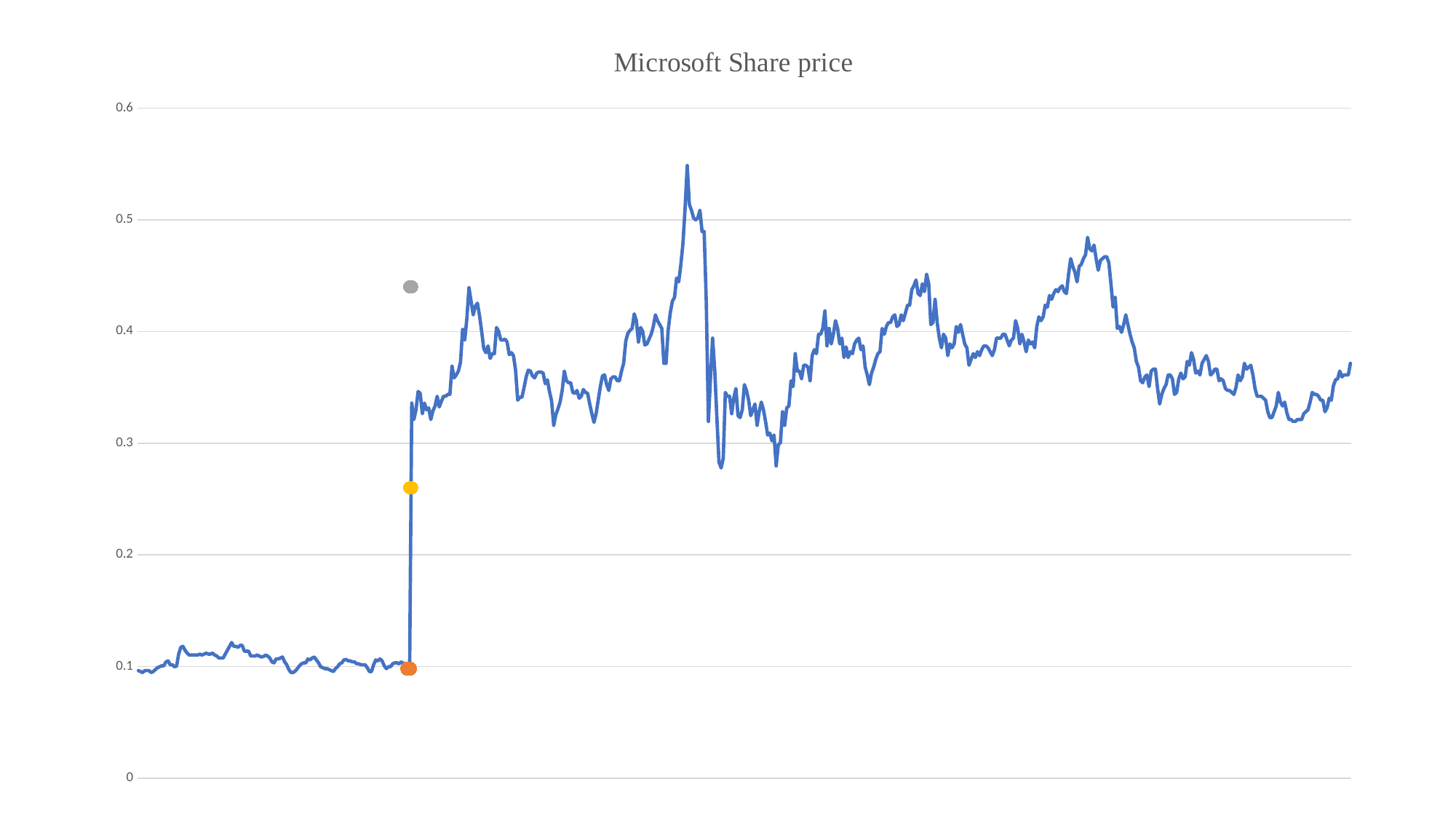
Is the value at the far left of the line greater or less than 0.2? less Is the highest peak of the line greater or less than 0.6? less What is the title of the chart? Microsoft Share price What is the highest value shown on the vertical axis? 0.6 Is the highest peak of the line greater or less than 0.5? greater How many coloured marker dots are placed near the sharp jump in the line? 3 What kind of chart is shown on the slide? line chart How many tick labels are shown on the vertical axis? 7 Overall, does the line rise or fall from the left side of the chart to the right side? rise